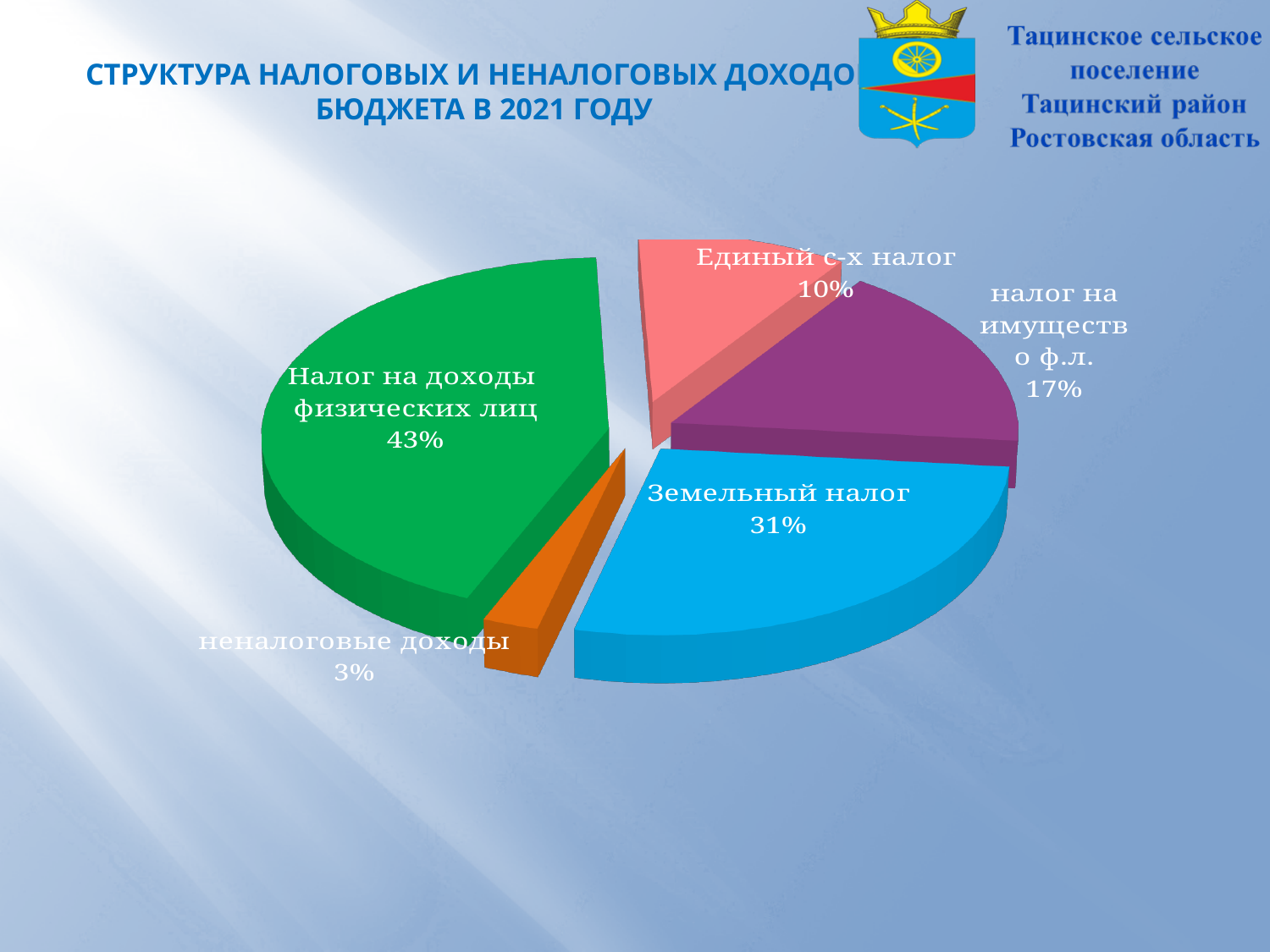
Which category has the largest slice of the pie? Налог на доходы физических лиц What share of the pie does Земельный налог have? 31% What colour is the slice for Земельный налог? blue What share of the pie does неналоговые доходы have? 3% What is the difference in percentage points between Налог на доходы физических лиц and Земельный налог? 12 What kind of chart is shown on the slide? pie chart What share of the pie does налог на имущество ф.л. have? 17% Which category has the smallest slice of the pie? неналоговые доходы Which is larger: налог на имущество ф.л. or Единый с-х налог? налог на имущество ф.л. How many slices does the pie chart have? 5